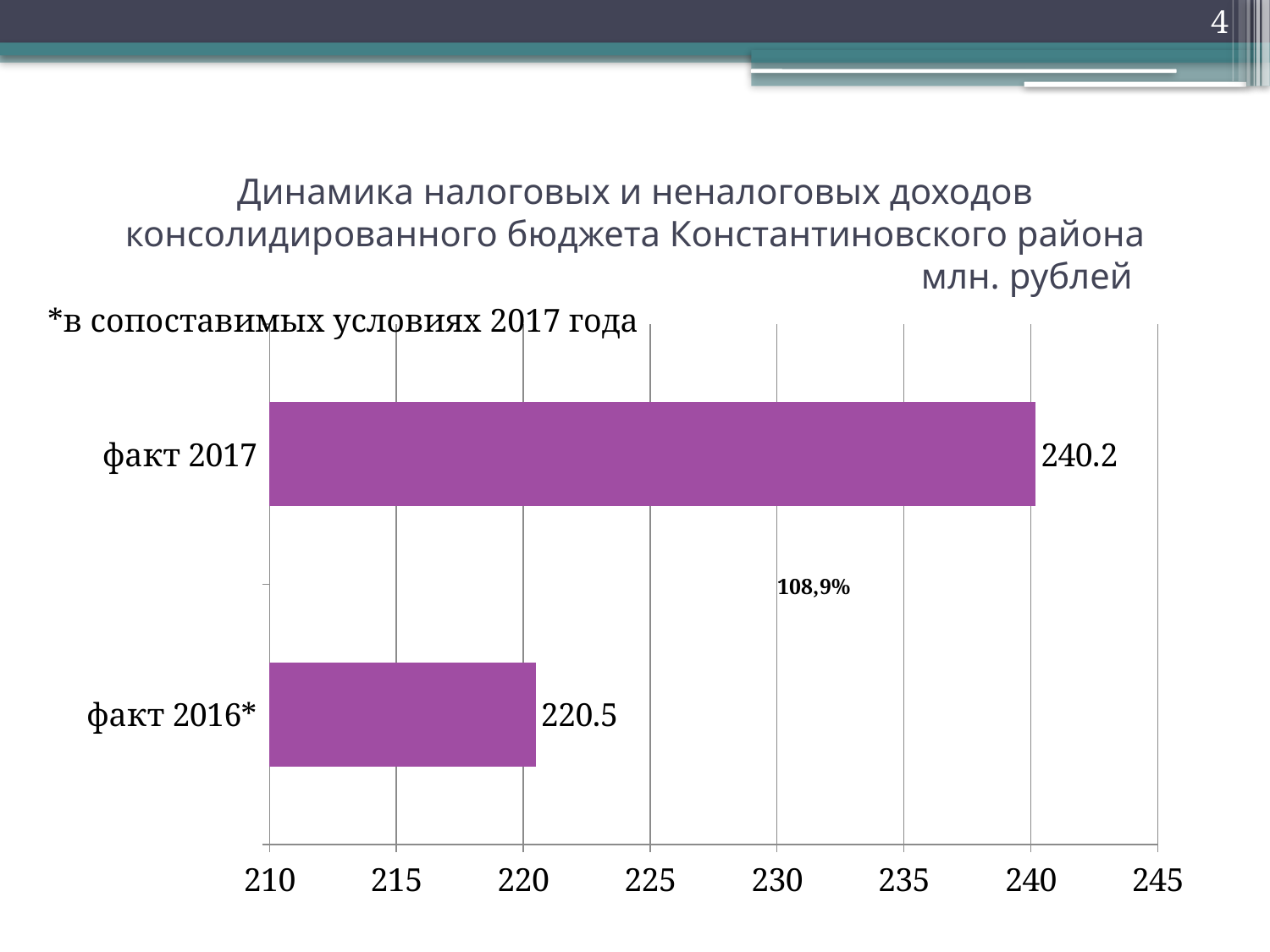
Is the value for факт 2017 greater or less than 235? greater How many categories are shown in the chart? 2 Which is larger, the value for факт 2017 or the value for факт 2016*? факт 2017 What is the value for факт 2016*? 220.5 What unit is stated for the chart values? млн. рублей What percentage label is shown between the two bars? 108,9% What is the difference between the values for факт 2017 and факт 2016*? 19.7 Is the value for факт 2016* greater or less than 225? less Which category has the highest value? факт 2017 What is the value for факт 2017? 240.2 What kind of chart is shown on the slide? bar chart Which category has the lowest value? факт 2016*